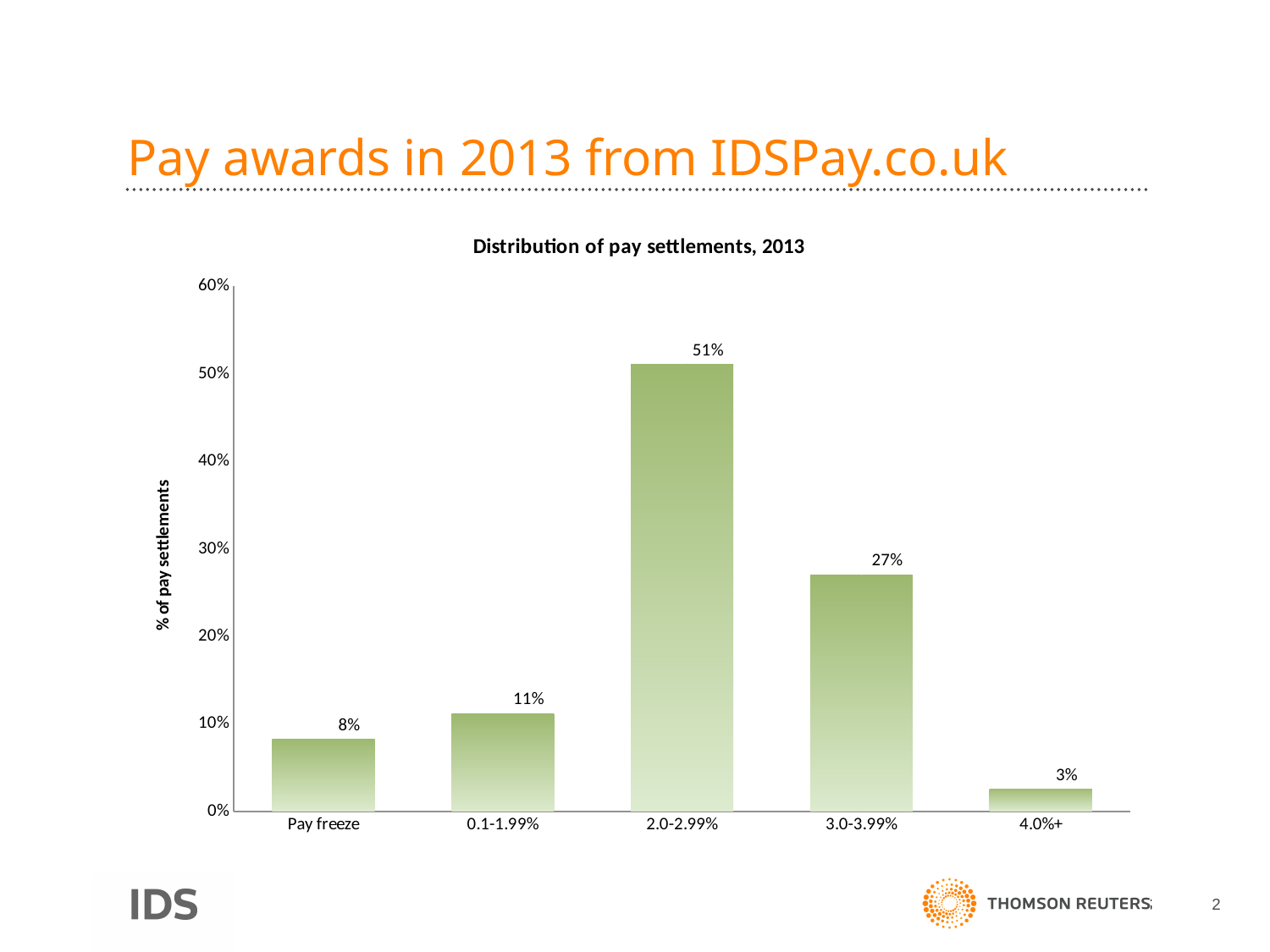
Which is larger, the value for Pay freeze or the value for 0.1-1.99%? 0.1-1.99% What is the title of the chart? Distribution of pay settlements, 2013 What percentage of pay settlements were in the 2.0-2.99% range? 51% What is the value for Pay freeze? 8% What is the difference between the 2.0-2.99% and 3.0-3.99% categories? 24% How many categories are shown on the x axis? 5 What is the value for the 3.0-3.99% category? 27% Which category has the lowest share of pay settlements? 4.0%+ Which category has the highest share of pay settlements? 2.0-2.99% Is the value for 3.0-3.99% greater or less than 30%? less What percentage of pay settlements were 4.0%+? 3% What kind of chart is shown on the slide? Bar chart